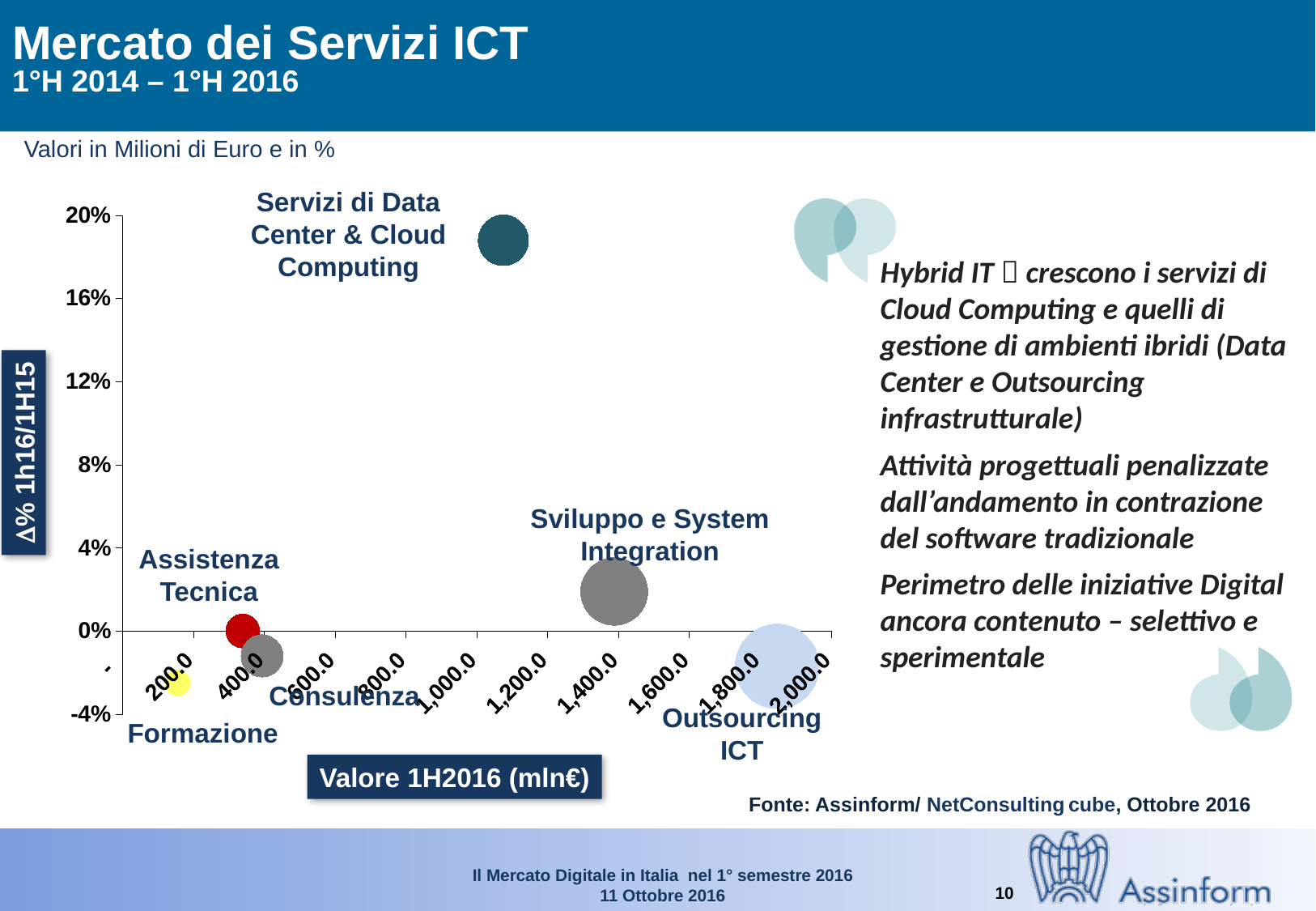
Which category shows the highest growth (Δ% 1h16/1H15) on the chart? Servizi di Data Center & Cloud Computing Is the 1H2016 value (mln€) for Sviluppo e System Integration greater or less than 1,200.0? greater Which category shows the lowest growth (Δ% 1h16/1H15) on the chart? Formazione What kind of chart is shown on the slide? bubble chart Is the 1H2016 value (mln€) for Outsourcing ICT greater or less than 1,600.0? greater Which has the higher growth rate: Servizi di Data Center & Cloud Computing or Sviluppo e System Integration? Servizi di Data Center & Cloud Computing Is the growth value for Servizi di Data Center & Cloud Computing greater or less than 16%? greater How many service categories (bubbles) are plotted on the chart? 6 Which has the larger 1H2016 value (mln€): Outsourcing ICT or Consulenza? Outsourcing ICT What is the label of the horizontal axis of the chart? Valore 1H2016 (mln€)